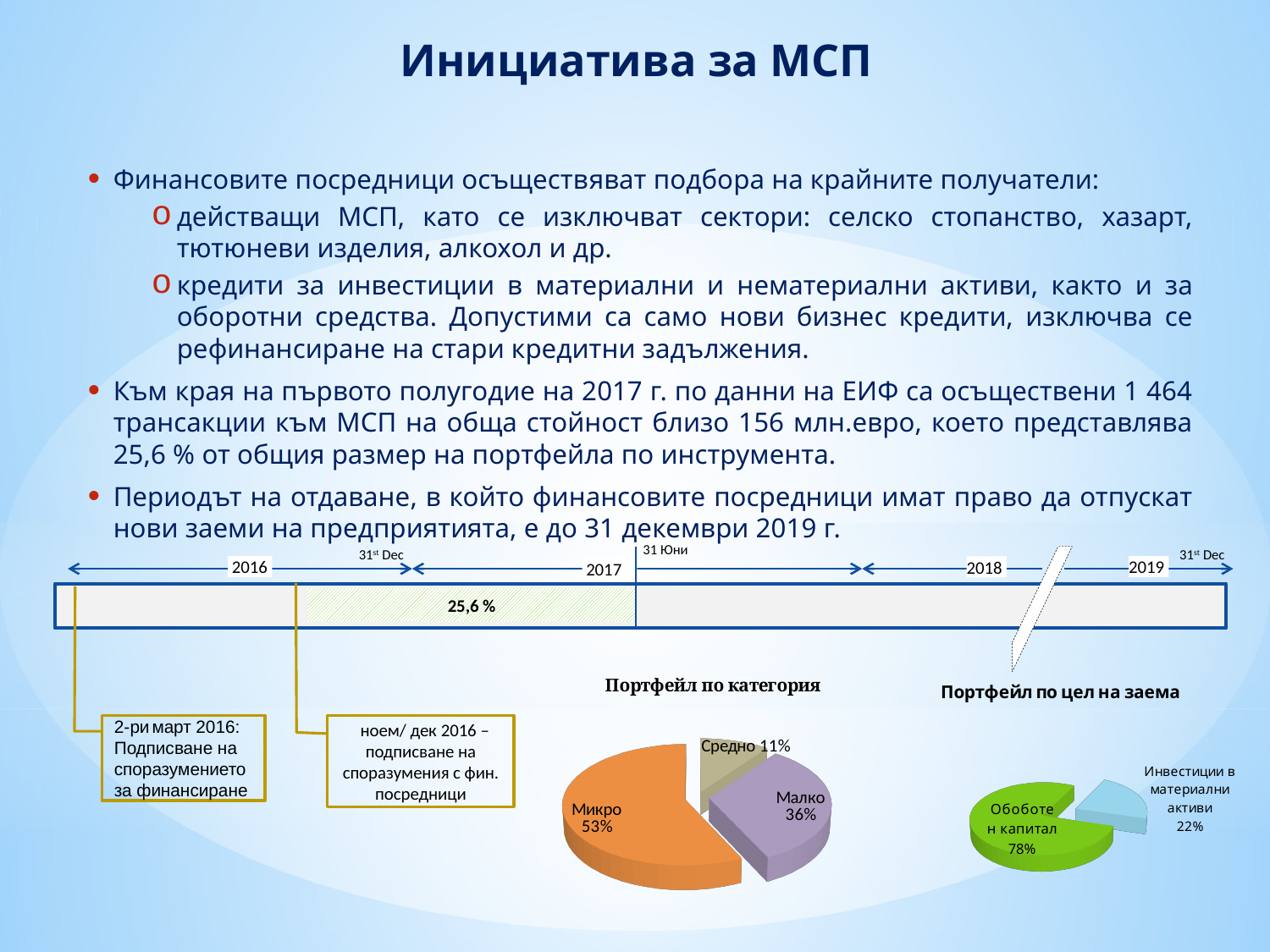
What kind of chart is "Портфейл по категория"? Pie chart In the chart titled "Портфейл по категория", which category has the smallest share? Средно In the chart titled "Портфейл по категория", how many slices does the pie have? 3 In the chart titled "Портфейл по цел на заема", what share does Оборотен капитал have? 78% In the chart titled "Портфейл по цел на заема", how many slices does the pie have? 2 In the chart titled "Портфейл по категория", which category has the largest share? Микро In the chart titled "Портфейл по категория", what is the difference in percentage points between Микро and Малко? 17 In the chart titled "Портфейл по цел на заема", which is larger: Оборотен капитал or Инвестиции в материални активи? Оборотен капитал In the chart titled "Портфейл по категория", what share does Микро have? 53% In the chart titled "Портфейл по цел на заема", what share does Инвестиции в материални активи have? 22% In the chart titled "Портфейл по категория", what share does Малко have? 36% In the chart titled "Портфейл по категория", what share does Средно have? 11%